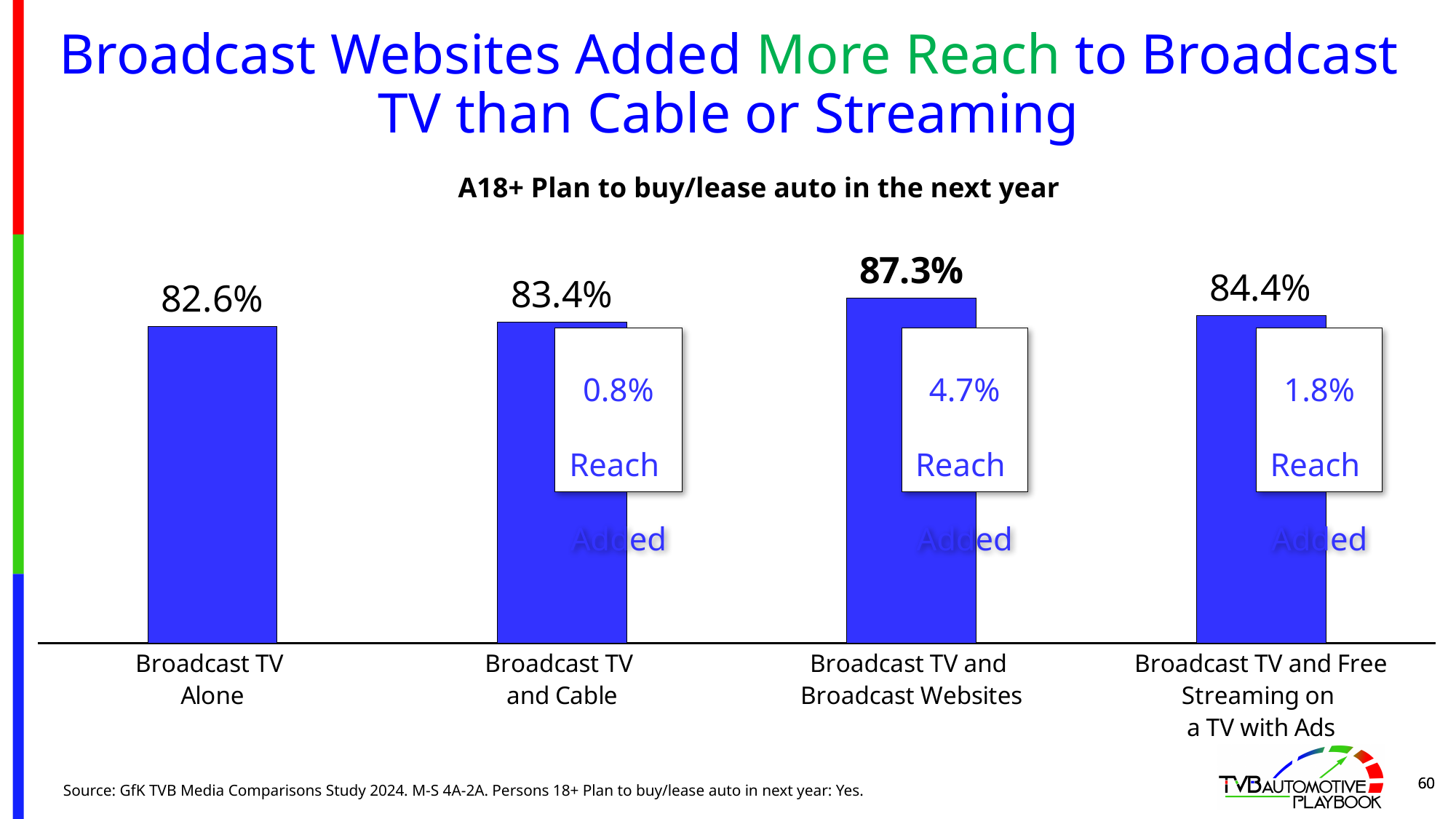
Which is larger, the value for Broadcast TV and Cable or the value for Broadcast TV and Free Streaming on a TV with Ads? Broadcast TV and Free Streaming on a TV with Ads What added reach is shown in the callout box for Broadcast TV and Broadcast Websites? 4.7% Reach Added Which category has the lowest value? Broadcast TV Alone What is the value for Broadcast TV Alone? 82.6% What is the value for Broadcast TV and Cable? 83.4% What is the difference between Broadcast TV and Free Streaming on a TV with Ads and Broadcast TV and Cable? 1.0% What kind of chart is shown on the slide? Bar chart What is the value for Broadcast TV and Free Streaming on a TV with Ads? 84.4% What is the difference between Broadcast TV and Broadcast Websites and Broadcast TV Alone? 4.7% What is the value for Broadcast TV and Broadcast Websites? 87.3% Which category has the highest value? Broadcast TV and Broadcast Websites How many categories are shown in the chart? 4